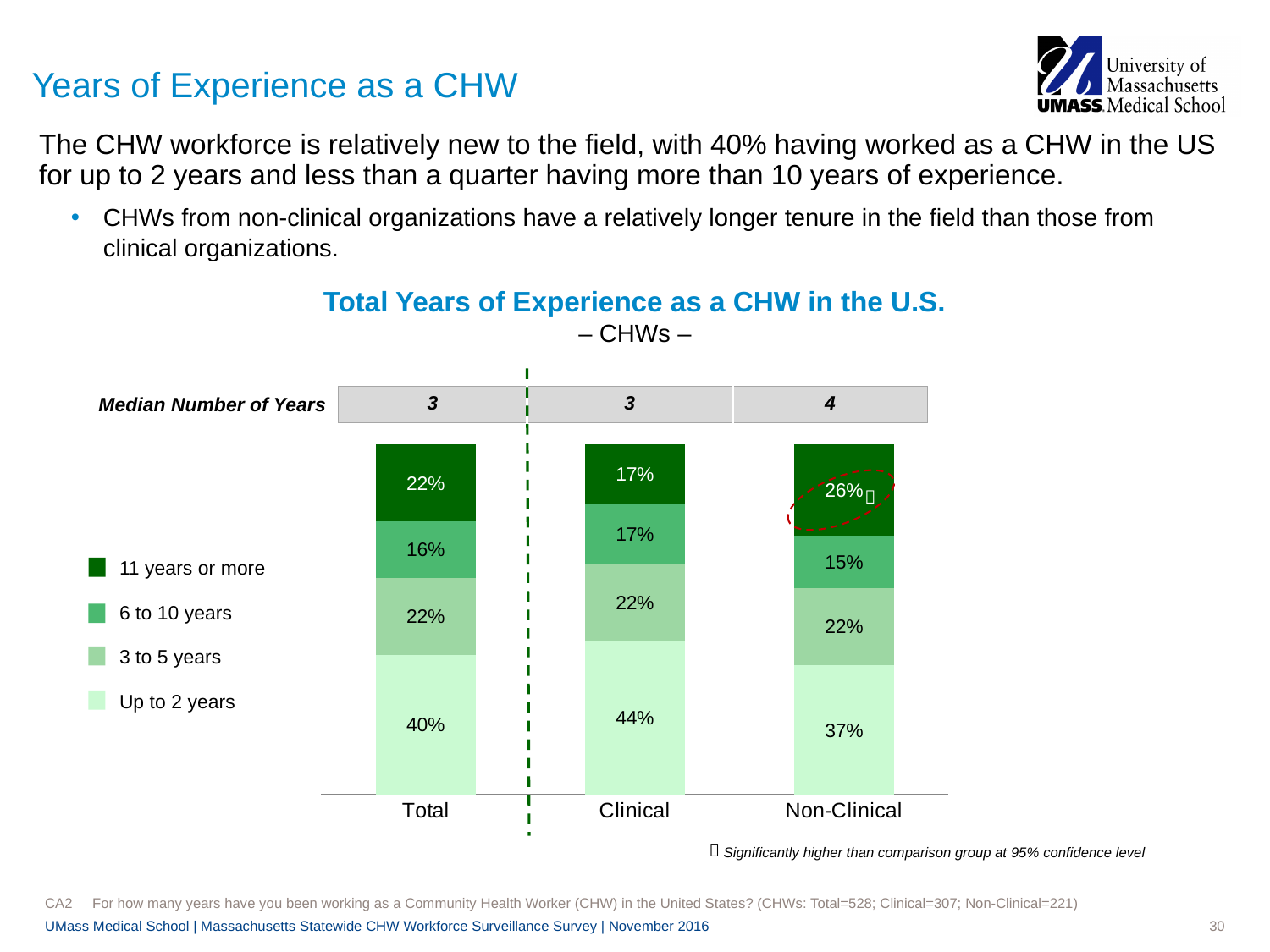
What is the difference between the Non-Clinical and Clinical shares of CHWs with 11 years or more of experience? 9% Which group has the highest share of CHWs with up to 2 years of experience? Clinical What percentage of Non-Clinical CHWs have 11 years or more of experience? 26% Which group has the lowest share of CHWs with 11 years or more of experience? Clinical What is the title of the chart? Total Years of Experience as a CHW in the U.S. What is the median number of years of experience for Non-Clinical CHWs? 4 How many groups (bars) are shown on the x axis? 3 What percentage of the Total group has 6 to 10 years of experience? 16% What kind of chart is shown on the slide? Stacked bar chart Which is larger: the share of Total CHWs with up to 2 years of experience or the share of Non-Clinical CHWs with up to 2 years of experience? Total What percentage of Clinical CHWs have up to 2 years of experience? 44% How many experience categories does the legend list? 4